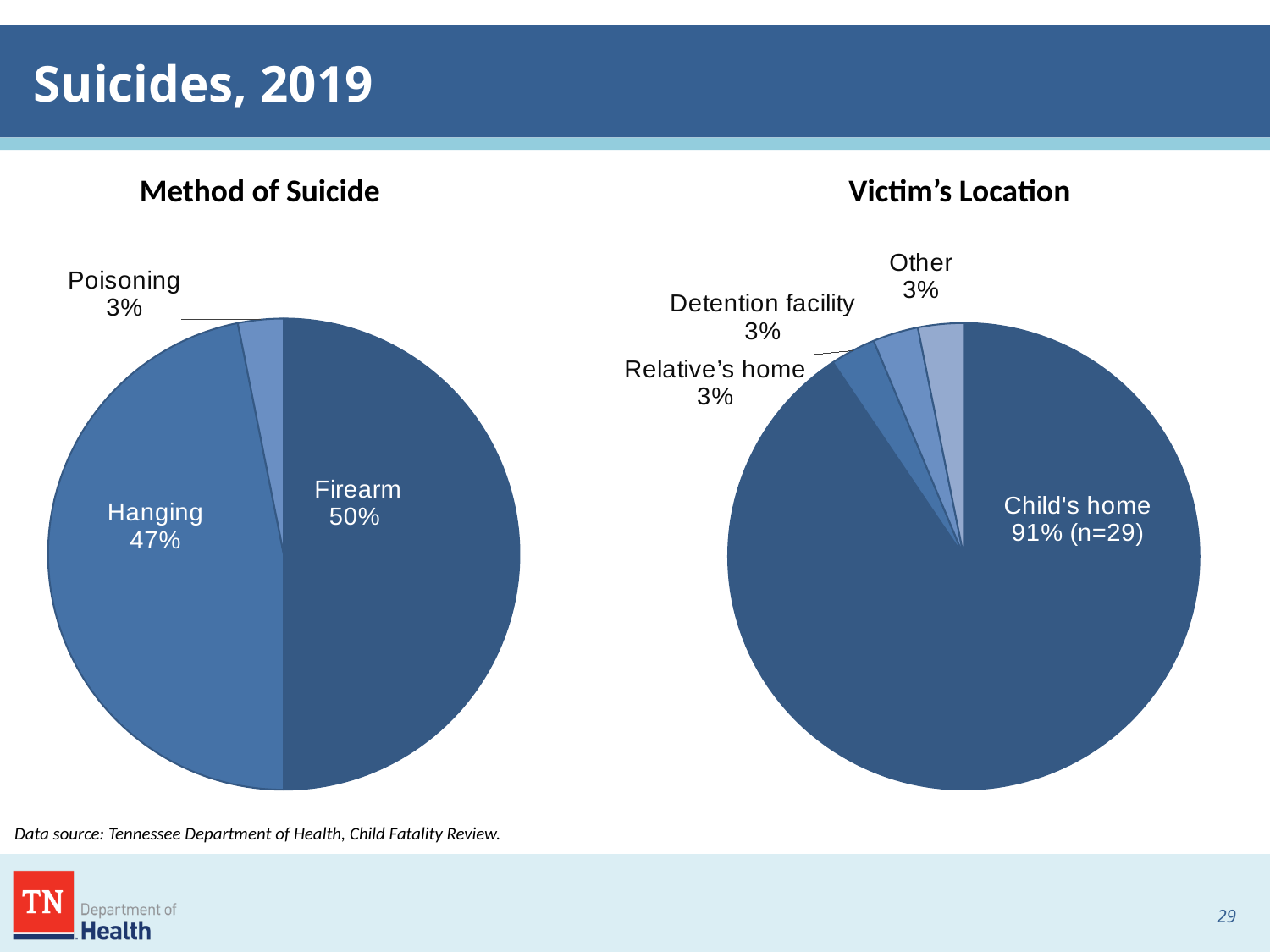
In the Victim's Location chart, how many victims were at the child's home (n)? 29 In the Method of Suicide chart, which method has the smallest share? Poisoning In the Method of Suicide chart, which method has the largest share? Firearm In the Method of Suicide chart, how many percentage points larger is Firearm than Hanging? 3 In the Victim's Location chart, what percentage is shown for Detention facility? 3% What type of chart is the Victim's Location chart? Pie chart What is the title of the slide? Suicides, 2019 In the Method of Suicide chart, what share of suicides were by firearm? 50% In the Victim's Location chart, what share of victims were at the child's home? 91% In the Method of Suicide chart, what percentage is shown for Hanging? 47% In the Victim's Location chart, how many location categories are shown? 4 In the Method of Suicide chart, how many categories are shown? 3